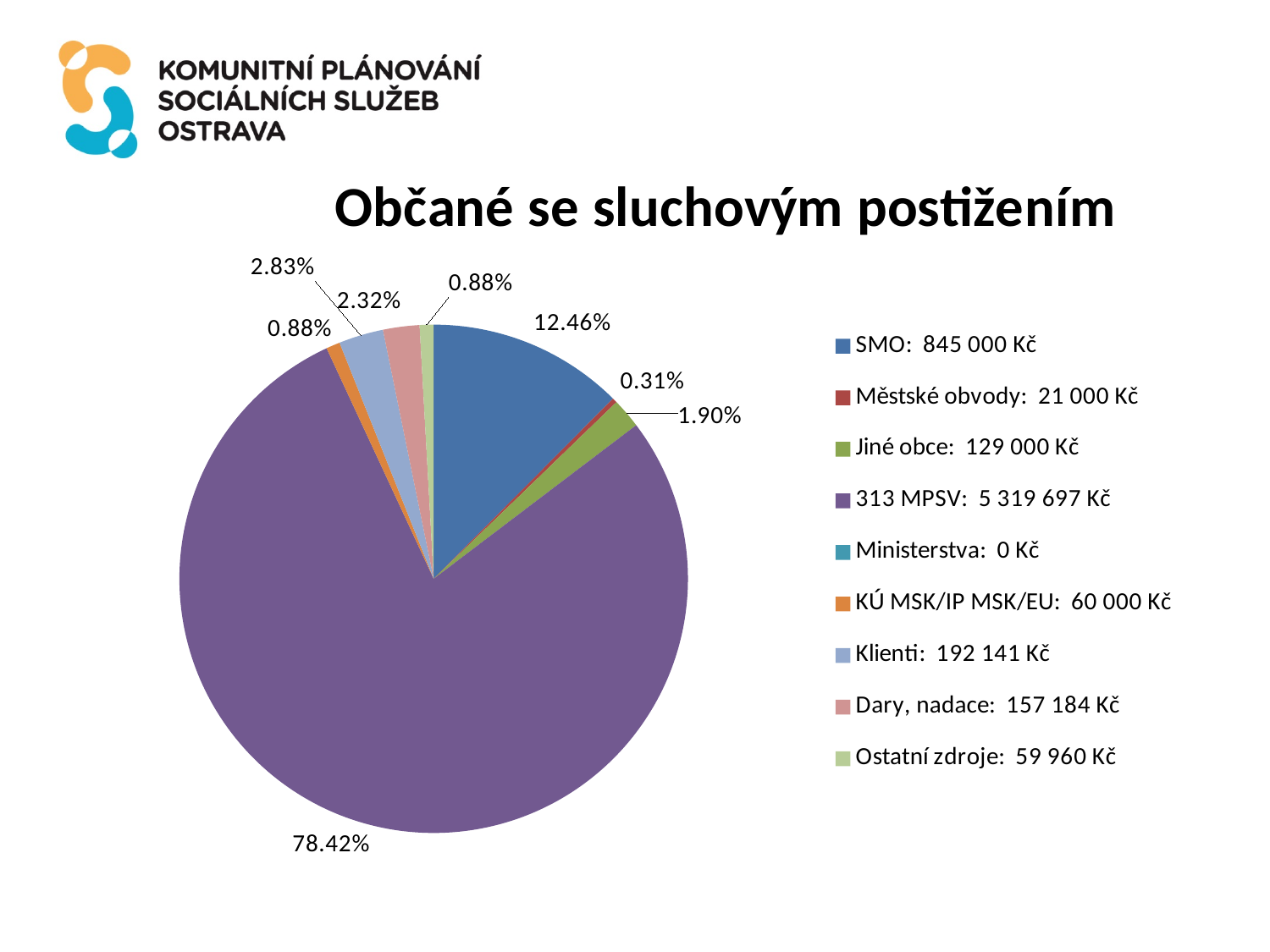
What is the title of the chart? Občané se sluchovým postižením Which category has the smallest amount in the legend? Ministerstva What amount is shown for 313 MPSV in the legend? 5 319 697 Kč How many categories does the legend list? 9 What kind of chart is shown on the slide? pie chart Which category has the largest share of the pie? 313 MPSV What share of the pie does SMO represent? 12.46% Which is larger, the amount for Klienti or the amount for Dary, nadace? Klienti What is the difference between the amounts for SMO and Jiné obce? 716 000 Kč What amount is shown for Klienti in the legend? 192 141 Kč What share of the pie does 313 MPSV represent? 78.42% What amount is shown for Dary, nadace in the legend? 157 184 Kč